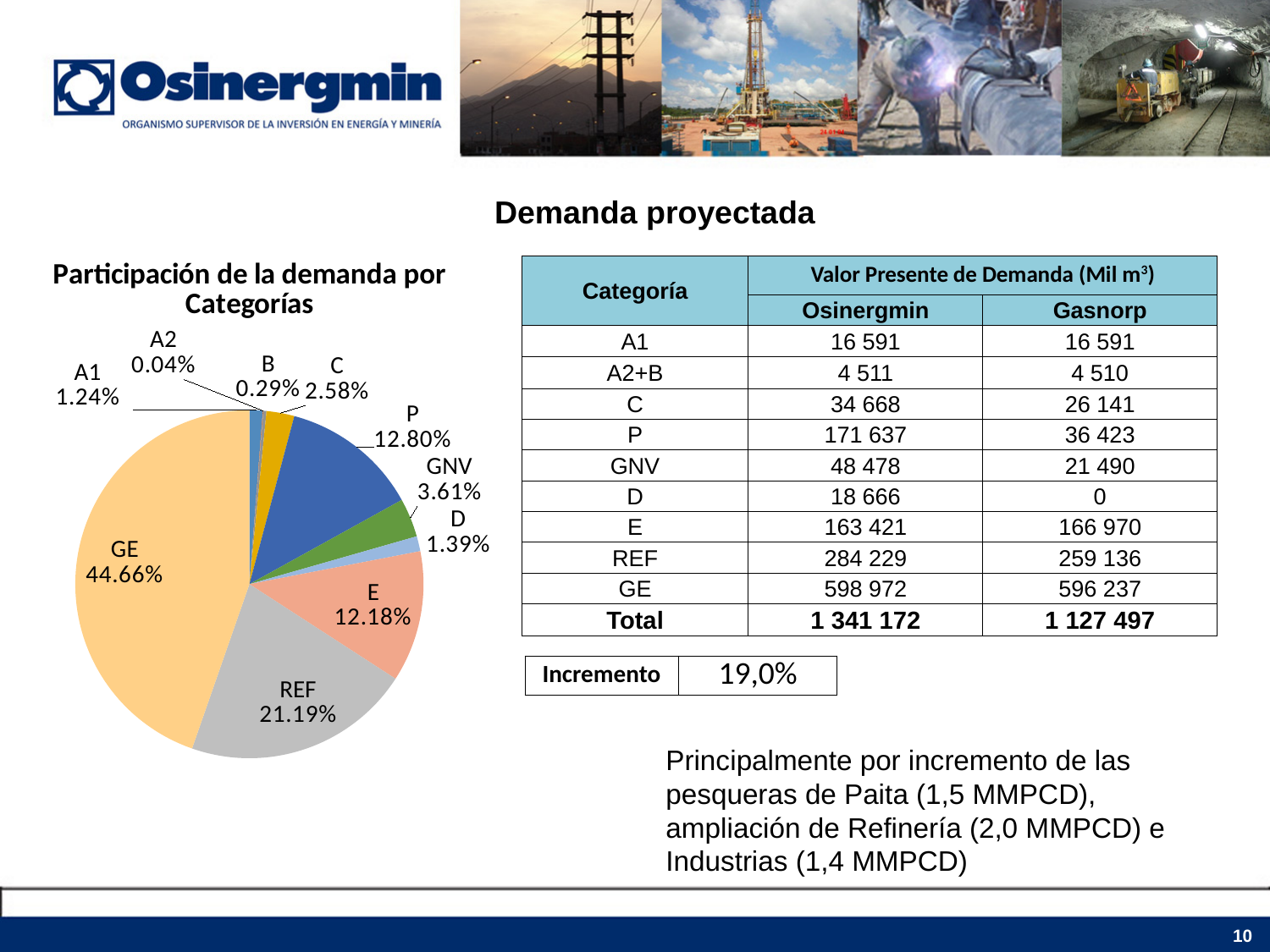
What type of chart is shown on the slide? Pie chart What is the title of the pie chart? Participación de la demanda por Categorías What is the value shown for GNV in the pie chart? 3.61% What is the value shown for REF in the pie chart? 21.19% Which has a larger share, P or E? P What is the difference between the shares of GE and REF? 23.47% What is the difference between the shares of D and A1? 0.15% Which category has the largest share of the pie? GE What share of the pie does GE have? 44.66% What is the value shown for P in the pie chart? 12.80% Which category has the smallest share of the pie? A2 How many slices does the pie chart have? 10